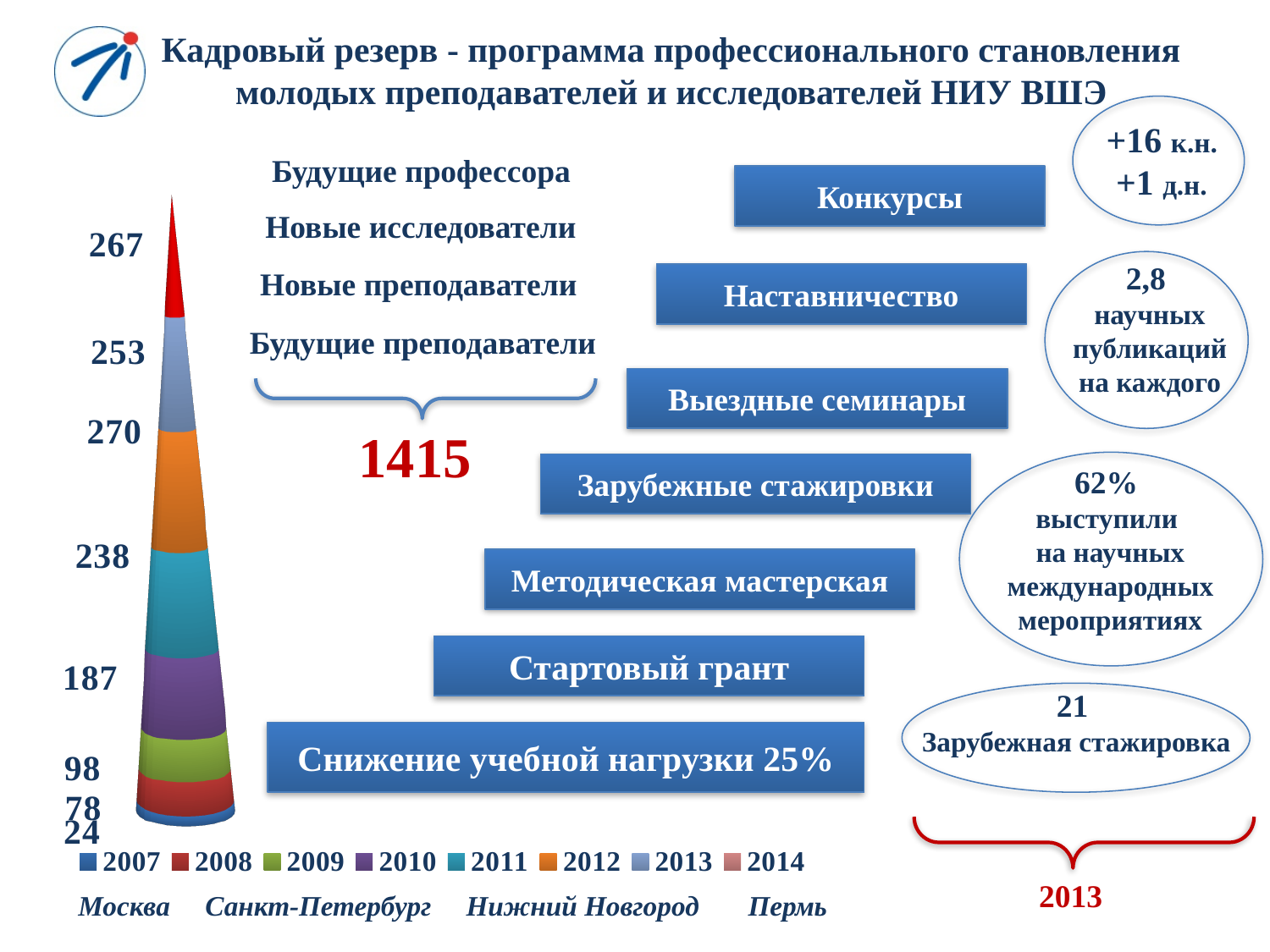
What is the total of all segments in the stacked chart, as printed on the slide? 1415 What value is shown for 2007 in the stacked chart? 24 Which year has the smallest value in the stacked chart? 2007 Which is larger, the value for 2013 or the value for 2014? 2014 Which year has the largest value in the stacked chart? 2012 Do the values rise or fall from 2007 to 2012? Rise How many years does the legend of the chart list? 8 What value is shown for 2012 in the stacked chart? 270 What value is shown for 2010 in the stacked chart? 187 What value is shown for 2014 in the stacked chart? 267 What kind of chart is shown on the slide? Stacked bar chart What is the difference between the values for 2011 and 2010? 51